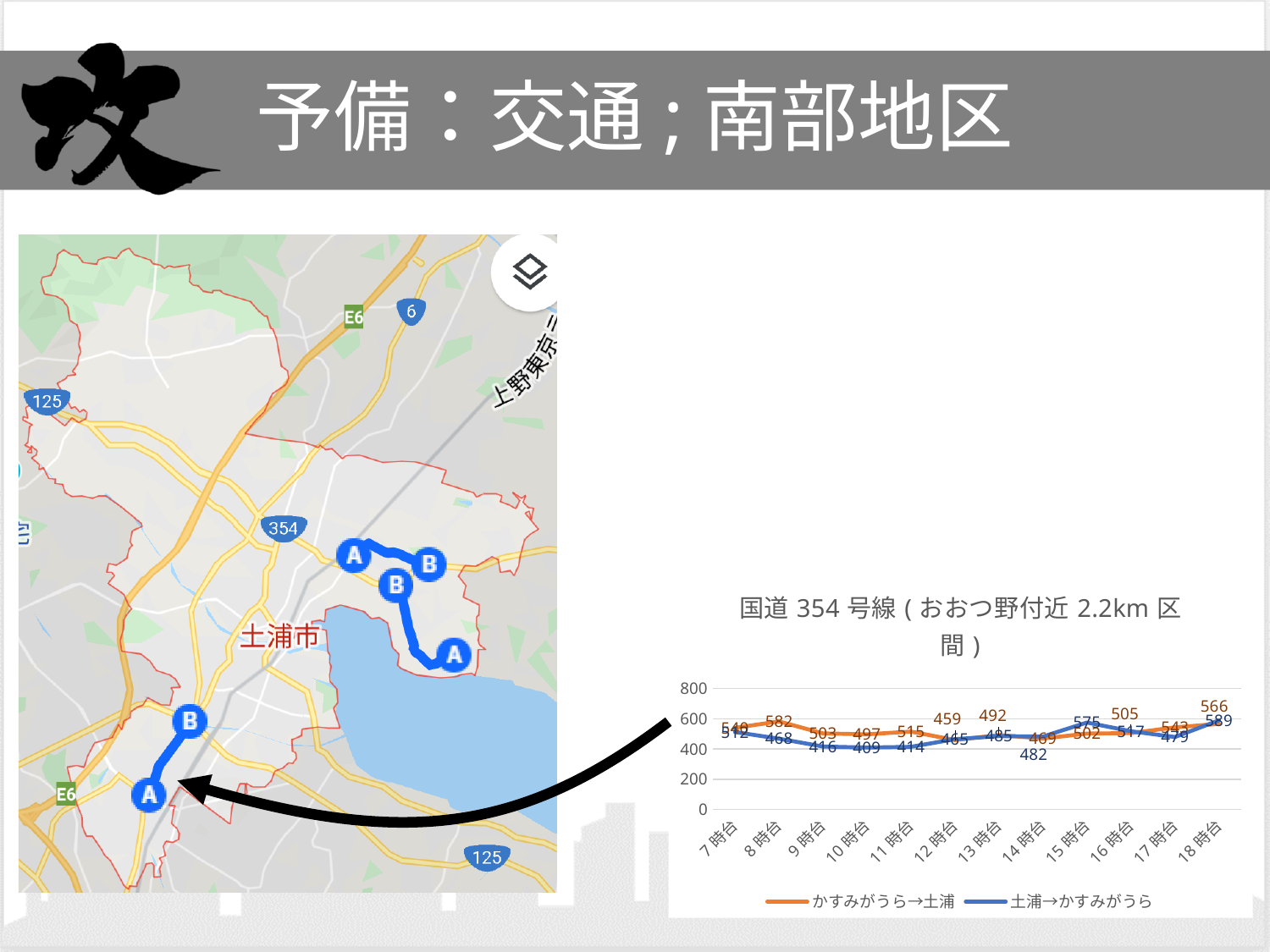
How many time-slot categories are shown on the x axis of the chart? 12 What is the value for 土浦→かすみがうら at 10時台? 409 What is the value for かすみがうら→土浦 at 8時台? 582 What is the title of the chart? 国道 354 号線 ( おおつ野付近 2.2km 区間 ) Is the value for 土浦→かすみがうら at 9時台 greater or less than 600? less What is the value for かすみがうら→土浦 at 17時台? 543 What is the value for 土浦→かすみがうら at 15時台? 575 What kind of chart is shown on the slide? line chart How many series does the chart legend list? 2 At which time slot does 土浦→かすみがうら reach its highest value? 18時台 What is the difference between 土浦→かすみがうら and かすみがうら→土浦 at 18時台? 23 At 17時台, which series has the larger value, かすみがうら→土浦 or 土浦→かすみがうら? かすみがうら→土浦